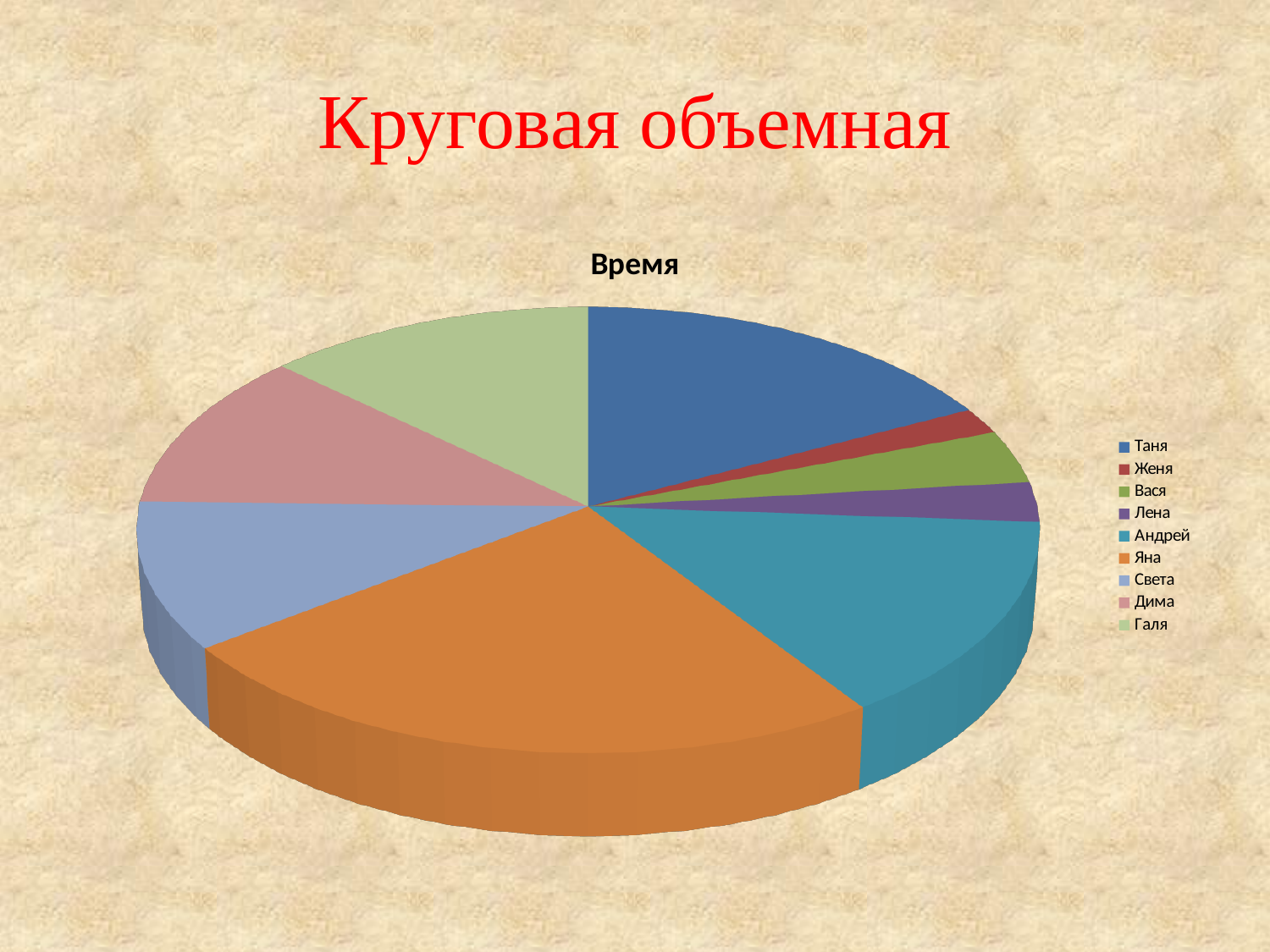
What is the title of the chart? Время How many categories does the pie chart have? 9 Which is larger, the slice for Таня or the slice for Вася? Таня Which category has the largest slice of the pie? Яна Which is larger, the slice for Яна or the slice for Андрей? Яна Which is larger, the slice for Дима or the slice for Вася? Дима How many entries does the legend list? 9 What kind of chart is shown on the slide? pie chart What colour is the slice for Яна? orange